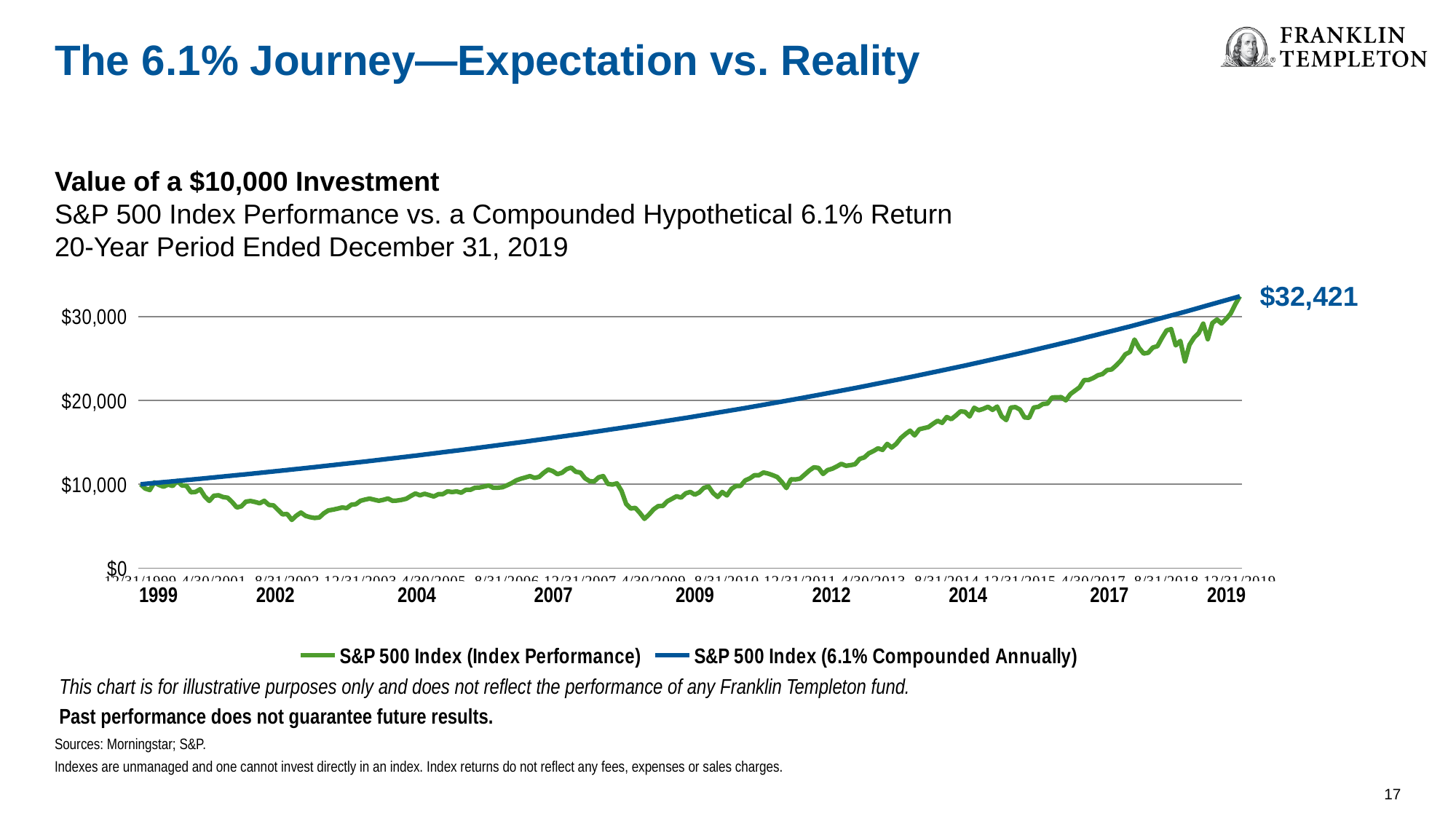
What type of chart is shown on the slide? line chart Is the value of the S&P 500 Index (Index Performance) line around 2002 greater or less than $10,000? less Does the S&P 500 Index (6.1% Compounded Annually) line rise or fall from 1999 to 2019? rise What is the ending value shown for the S&P 500 Index (6.1% Compounded Annually) line? $32,421 Is the value of the S&P 500 Index (Index Performance) line around 2017 greater or less than $20,000? greater What is the starting value of the investment shown in the chart? $10,000 What colour is the S&P 500 Index (Index Performance) line? green Around 2009, which line is higher: S&P 500 Index (Index Performance) or S&P 500 Index (6.1% Compounded Annually)? S&P 500 Index (6.1% Compounded Annually) What is the title of the chart? Value of a $10,000 Investment Is the value of the S&P 500 Index (6.1% Compounded Annually) line around 2009 greater or less than $20,000? less How many series does the chart's legend list? 2